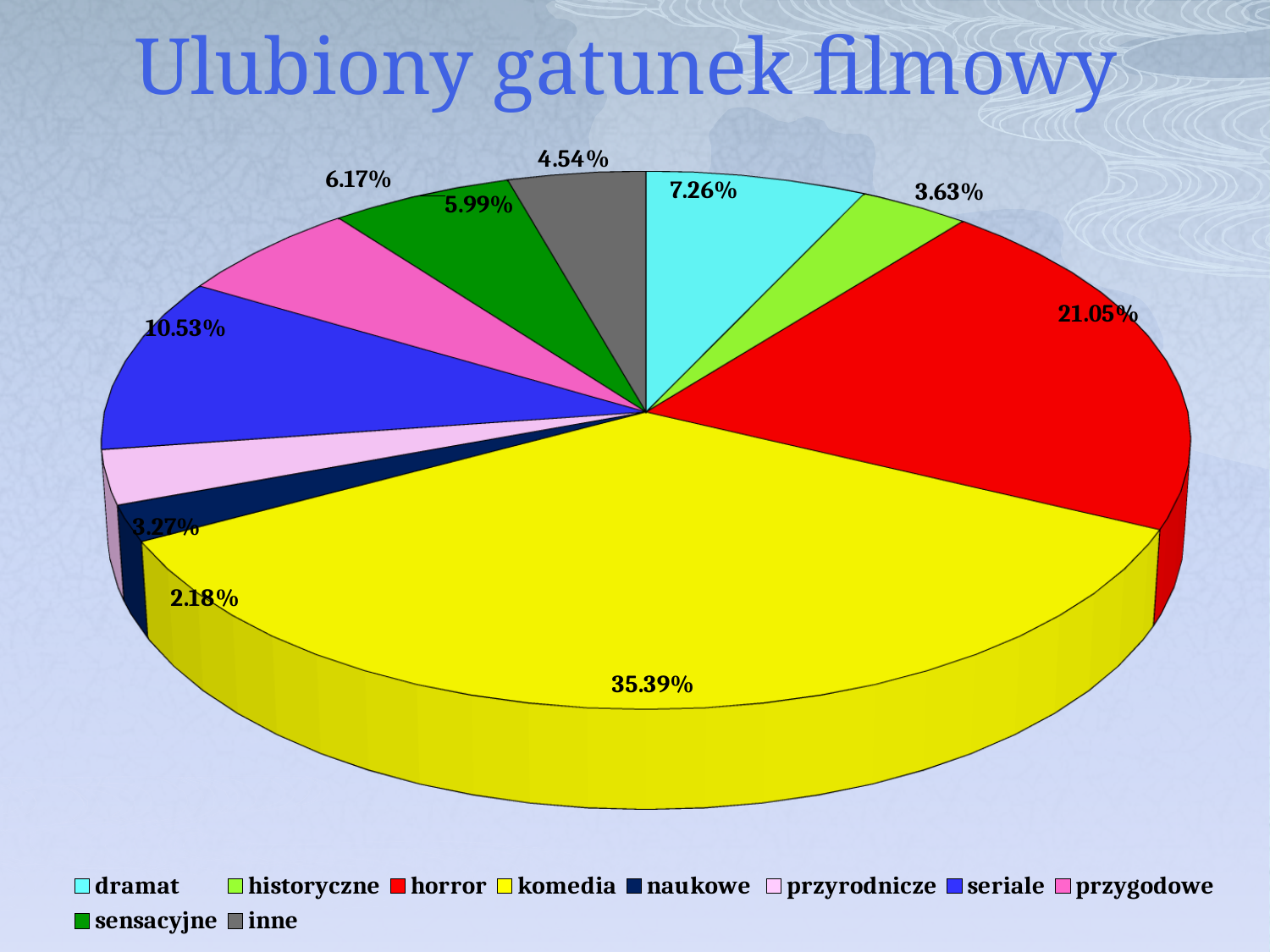
Which has a larger share, dramat or przygodowe? dramat How many categories does the legend list? 10 What is the title of the chart? Ulubiony gatunek filmowy Which category has the smallest share of the pie? naukowe What percentage of the pie is horror? 21.05% What is the difference in percentage points between komedia and horror? 14.34 What type of chart is shown on the slide? pie chart What percentage of the pie is seriale? 10.53% What percentage of the pie is komedia? 35.39% What percentage of the pie is inne? 4.54% What percentage of the pie is naukowe? 2.18% Which category has the largest share of the pie? komedia